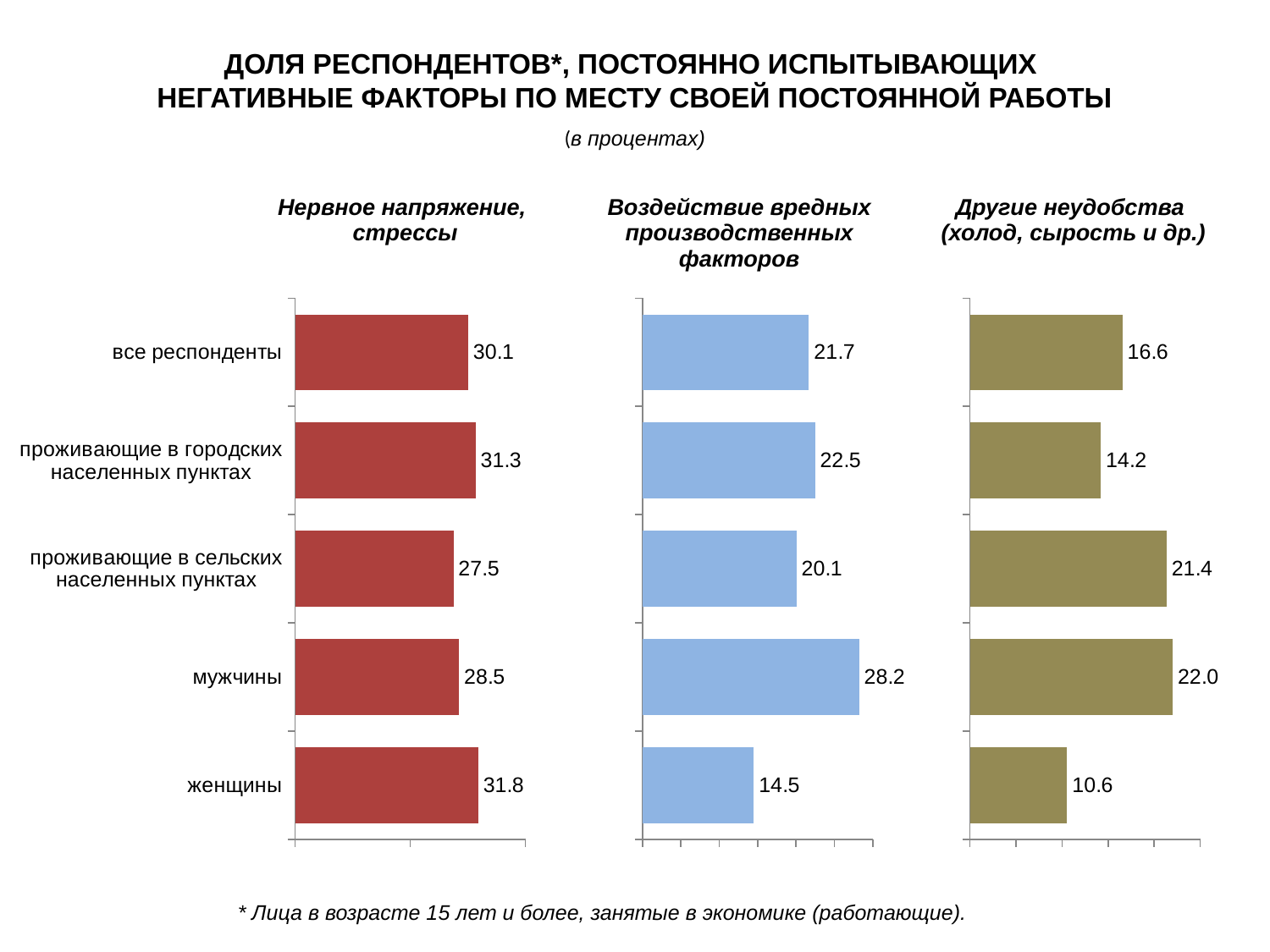
In the chart titled "Нервное напряжение, стрессы", what is the value for "женщины"? 31.8 In the chart titled "Нервное напряжение, стрессы", what is the difference between the values for "проживающие в городских населенных пунктах" and "проживающие в сельских населенных пунктах"? 3.8 In the chart titled "Другие неудобства (холод, сырость и др.)", which category has the lowest value? женщины What colour are the bars in the chart titled "Другие неудобства (холод, сырость и др.)"? olive green What kind of chart is the chart titled "Воздействие вредных производственных факторов"? bar chart In the chart titled "Другие неудобства (холод, сырость и др.)", what is the value for "все респонденты"? 16.6 In the chart titled "Воздействие вредных производственных факторов", what is the difference between the values for "мужчины" and "женщины"? 13.7 In the chart titled "Нервное напряжение, стрессы", which category has the lowest value? проживающие в сельских населенных пунктах How many categories are shown in the chart titled "Нервное напряжение, стрессы"? 5 In the chart titled "Воздействие вредных производственных факторов", what is the value for "мужчины"? 28.2 In the chart titled "Другие неудобства (холод, сырость и др.)", which is larger: the value for "проживающие в городских населенных пунктах" or "проживающие в сельских населенных пунктах"? проживающие в сельских населенных пунктах In the chart titled "Воздействие вредных производственных факторов", which category has the highest value? мужчины